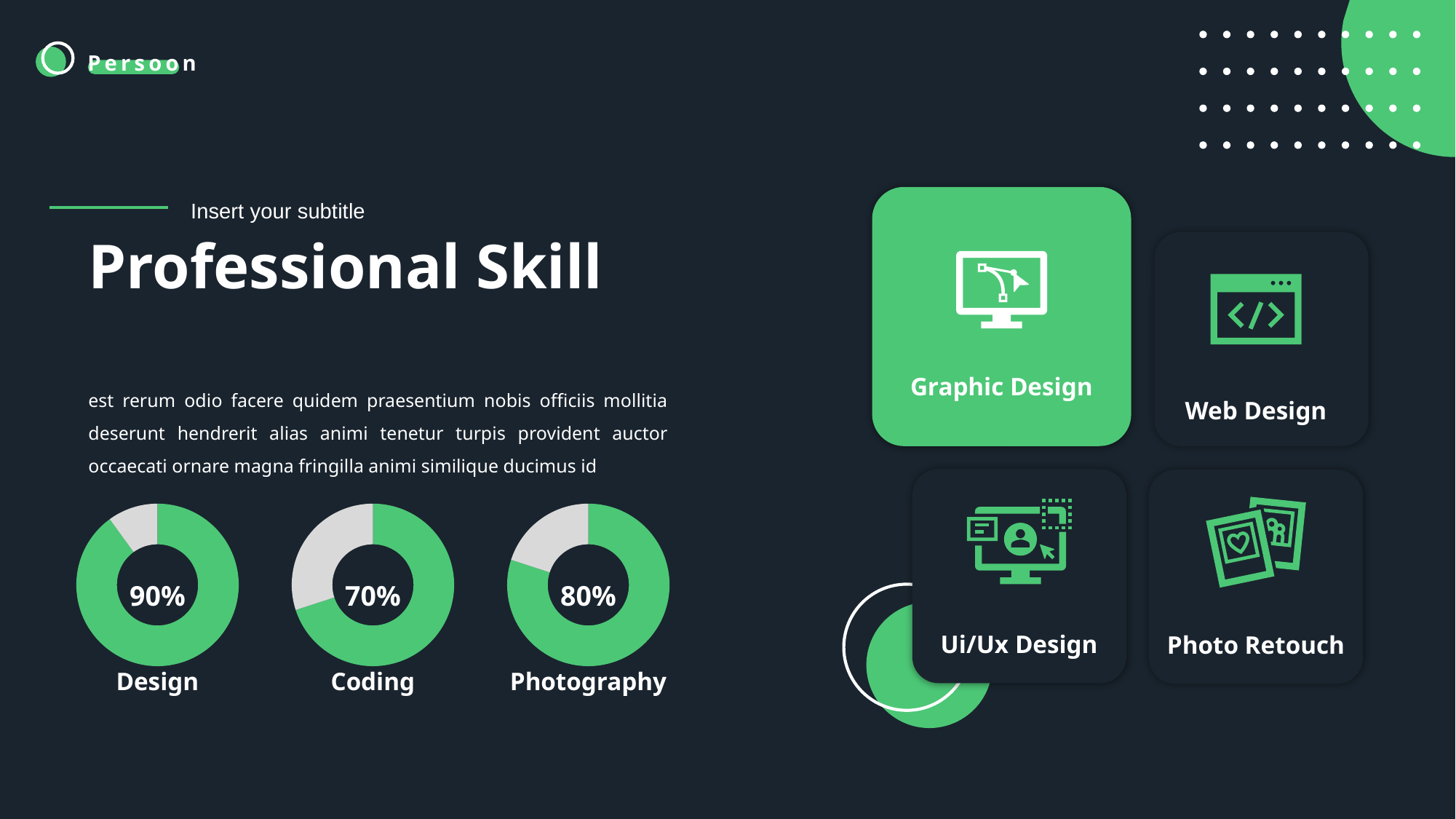
Which of the three donut charts shows the highest value? Design What value is shown in the Design donut chart? 90% What kind of chart is used to show the Design, Coding and Photography skills? Donut chart What is the difference between the Photography value and the Coding value? 10% How many donut charts are shown on the slide? 3 Which is larger, the Photography value or the Coding value? Photography What is the difference between the Design value and the Coding value? 20% What value is shown in the Coding donut chart? 70% What is the title of the slide containing the donut charts? Professional Skill What colour is the filled portion of each donut chart? Green What value is shown in the Photography donut chart? 80% Which of the three donut charts shows the lowest value? Coding